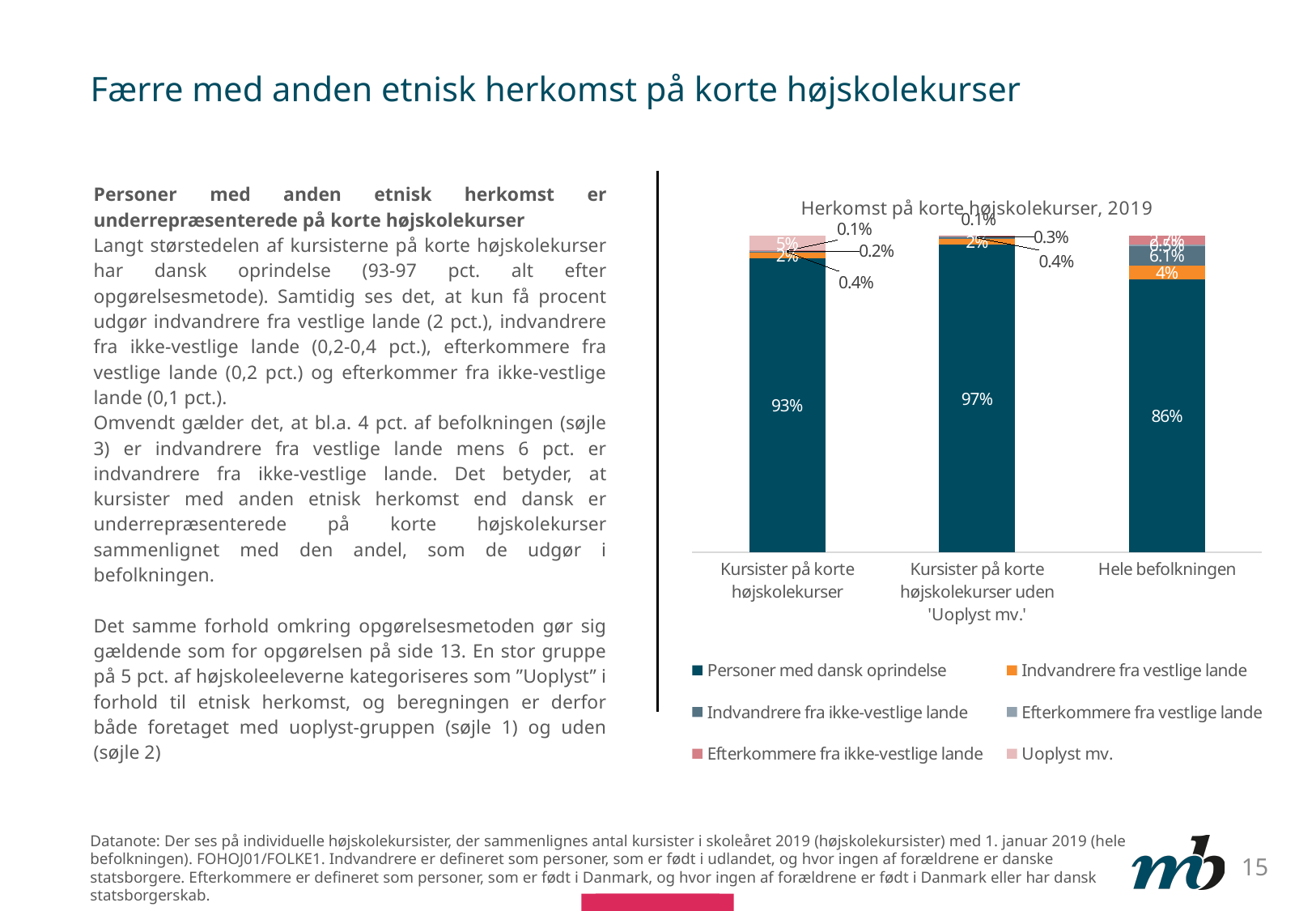
What is the share of 'Indvandrere fra ikke-vestlige lande' for 'Hele befolkningen'? 6.1% What is the share of 'Personer med dansk oprindelse' for 'Kursister på korte højskolekurser uden 'Uoplyst mv.''? 97% Which category has the lowest share of 'Personer med dansk oprindelse'? Hele befolkningen What is the share of 'Personer med dansk oprindelse' for 'Hele befolkningen'? 86% What is the title of the chart? Herkomst på korte højskolekurser, 2019 What is the difference in the share of 'Personer med dansk oprindelse' between 'Kursister på korte højskolekurser uden 'Uoplyst mv.'' and 'Hele befolkningen'? 11 percentage points How many categories are shown on the x axis of the chart? 3 What is the share of 'Indvandrere fra vestlige lande' for 'Hele befolkningen'? 4% What is the share of 'Uoplyst mv.' for 'Kursister på korte højskolekurser'? 5% What is the share of 'Personer med dansk oprindelse' for 'Kursister på korte højskolekurser'? 93% How many series does the chart's legend list? 6 What kind of chart is shown on the slide? Stacked bar chart